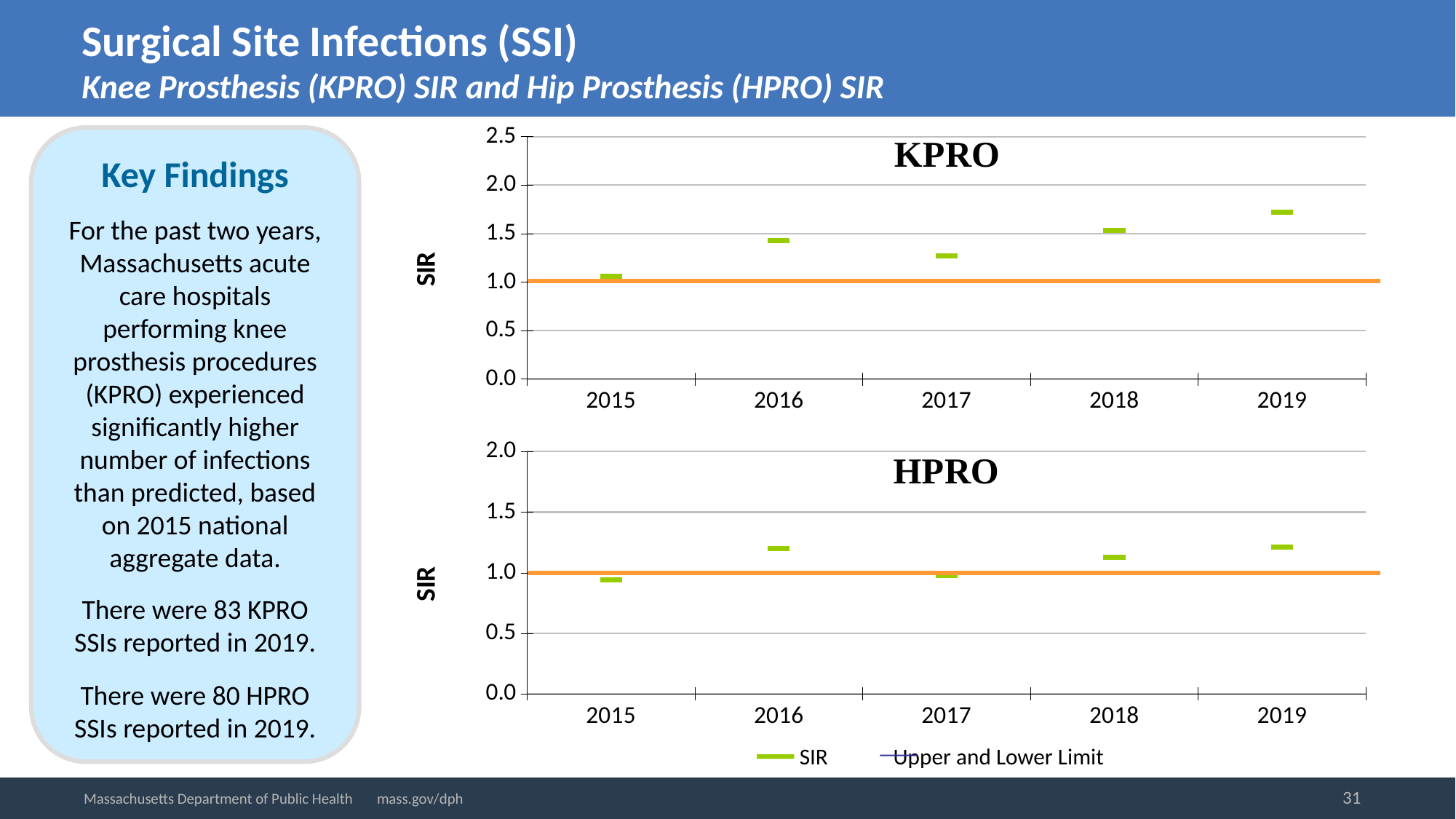
In the HPRO chart, is the SIR for 2015 greater or less than 1.0? less In the KPRO chart, which year has the highest SIR? 2019 How many series does the legend below the HPRO chart list? 2 How many years are plotted on the x axis of the KPRO chart? 5 In the KPRO chart, is the SIR for 2016 greater or less than 1.0? greater In the HPRO chart, which is larger, the SIR for 2017 or the SIR for 2018? 2018 In the HPRO chart, is the SIR for 2016 greater or less than 1.0? greater In the KPRO chart, which is larger, the SIR for 2016 or the SIR for 2017? 2016 In the KPRO chart, which year has the lowest SIR? 2015